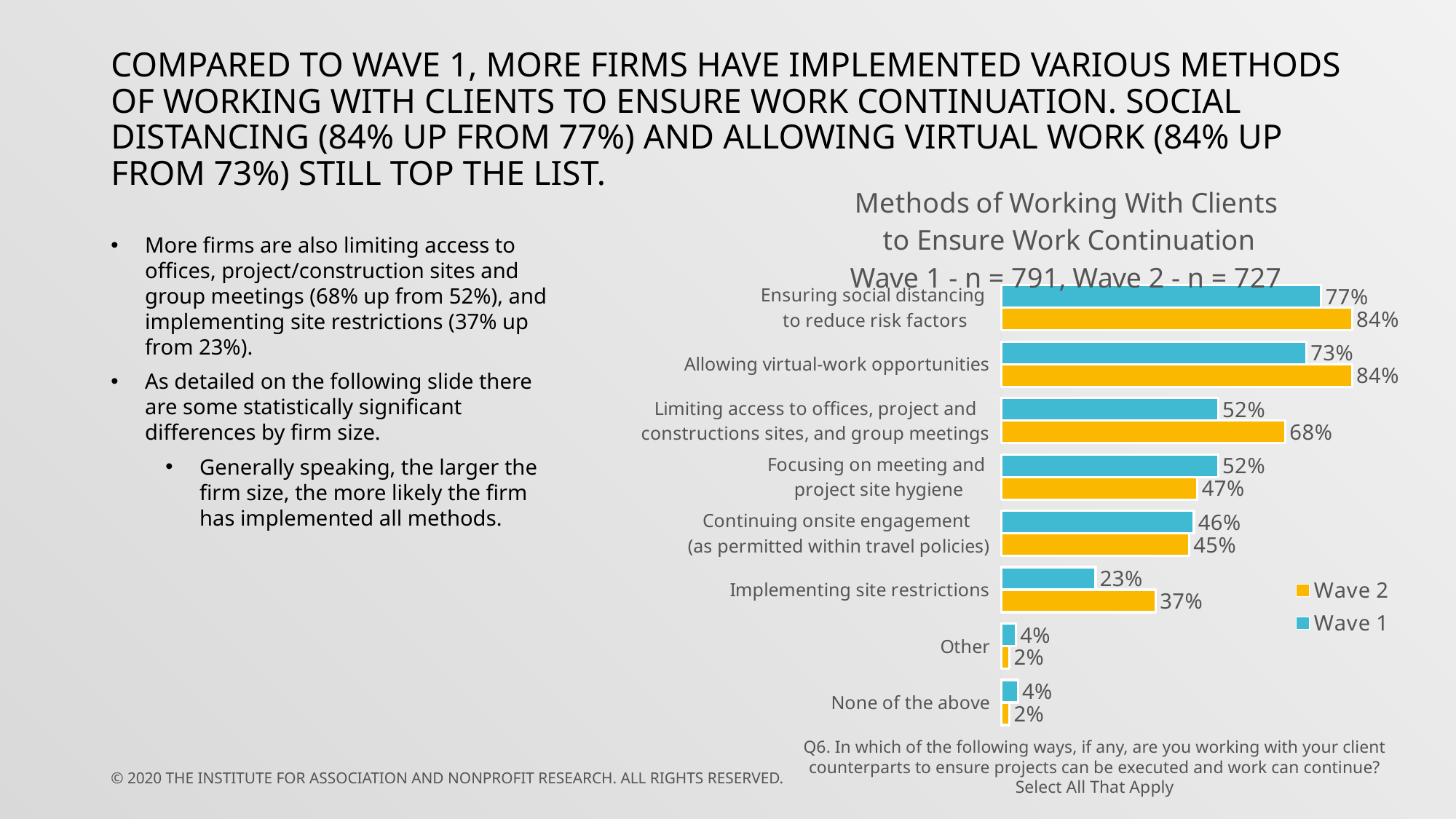
Which category has the lowest Wave 1 value? Other and None of the above (both 4%) What is the Wave 2 value for Implementing site restrictions? 37% Which colour represents Wave 2 in the chart? Yellow/orange How many categories are shown in the chart? 8 What kind of chart is shown on the slide? Bar chart For Focusing on meeting and project site hygiene, which is larger: the Wave 1 value or the Wave 2 value? Wave 1 What is the difference between the Wave 2 and Wave 1 values for Limiting access to offices, project and constructions sites, and group meetings? 16 percentage points What is the Wave 2 value for Ensuring social distancing to reduce risk factors? 84% What is the difference between the Wave 2 and Wave 1 values for Implementing site restrictions? 14 percentage points What is the Wave 1 value for Continuing onsite engagement (as permitted within travel policies)? 46% How many series does the legend list? 2 What is the Wave 1 value for Allowing virtual-work opportunities? 73%